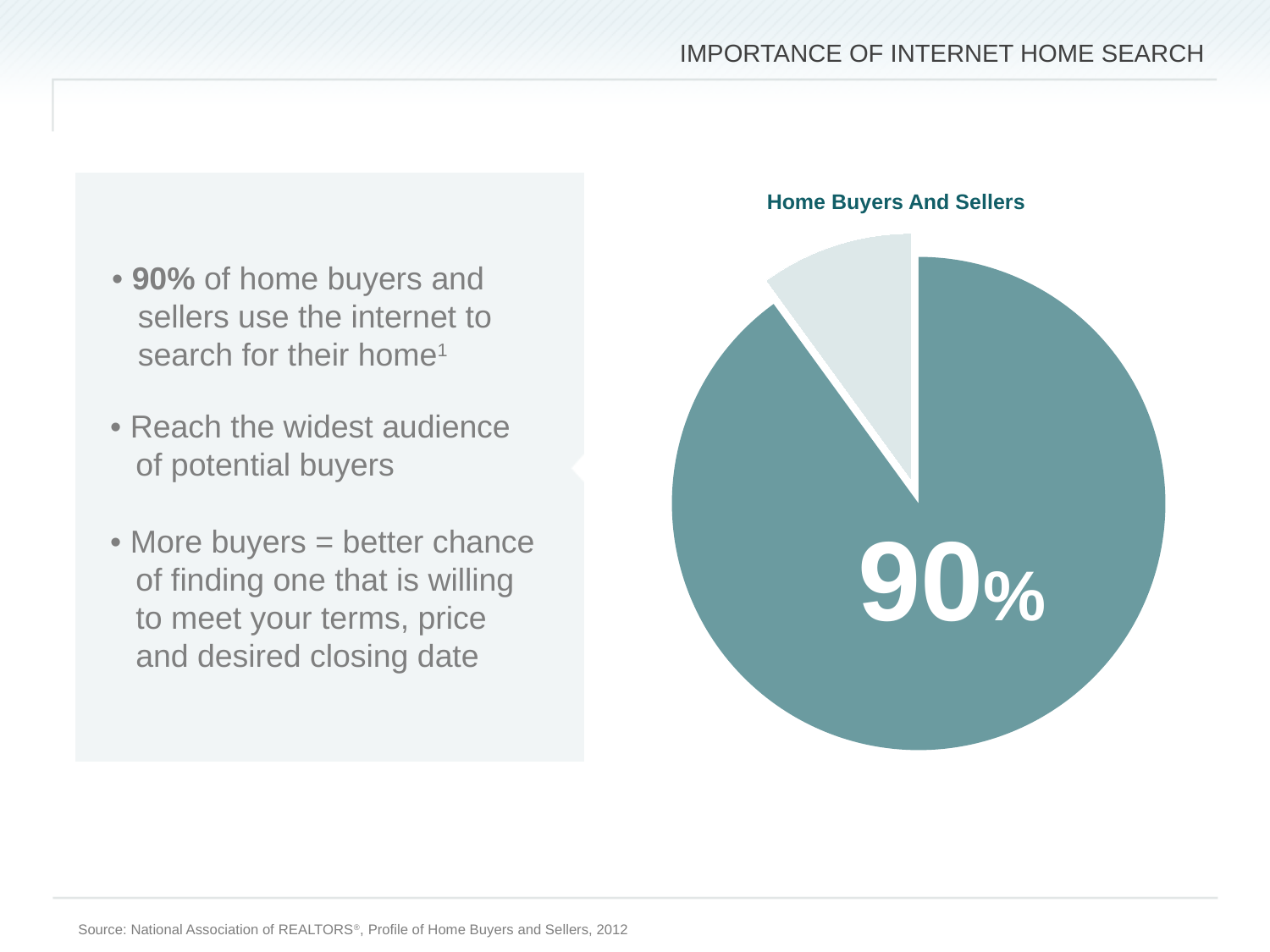
What value is printed on the large slice of the pie chart? 90% What colour is the largest slice of the pie chart? Dark teal Which slice of the pie chart is larger, the dark teal slice or the light grey slice? The dark teal slice What is the title of the pie chart? Home Buyers And Sellers Is the share of the dark teal slice greater or less than 50%? greater What kind of chart is shown on the slide? Pie chart What share of the pie does the dark teal slice represent? 90% How many slices does the pie chart have? 2